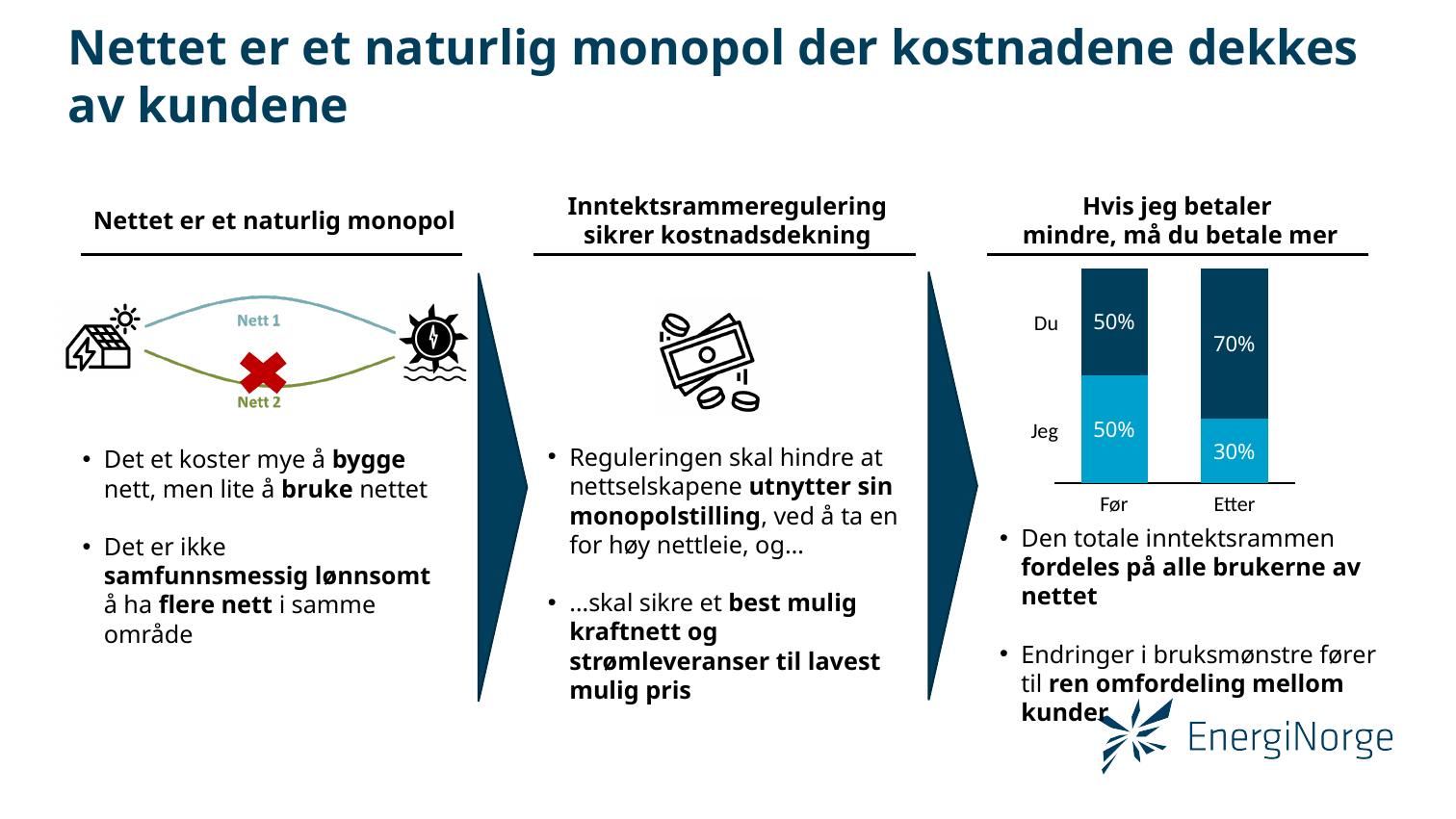
What is the difference between the "Du" and "Jeg" values in the "Etter" bar? 40% Does the "Jeg" value rise or fall from "Før" to "Etter"? Fall By how much does the "Du" value change from "Før" to "Etter"? 20% What is the total of the "Etter" stacked bar? 100% In the "Etter" bar, which segment is larger, "Du" or "Jeg"? Du In the chart, what is the value for "Jeg" in the "Etter" bar? 30% What type of chart is shown under the heading "Hvis jeg betaler mindre, må du betale mer"? Stacked bar chart In the chart, what is the value for "Jeg" in the "Før" bar? 50% How many series are stacked in each bar of the chart? 2 How many bars (categories) are shown on the x axis of the chart? 2 In the chart, what is the value for "Du" in the "Før" bar? 50% In the chart, what is the value for "Du" in the "Etter" bar? 70%